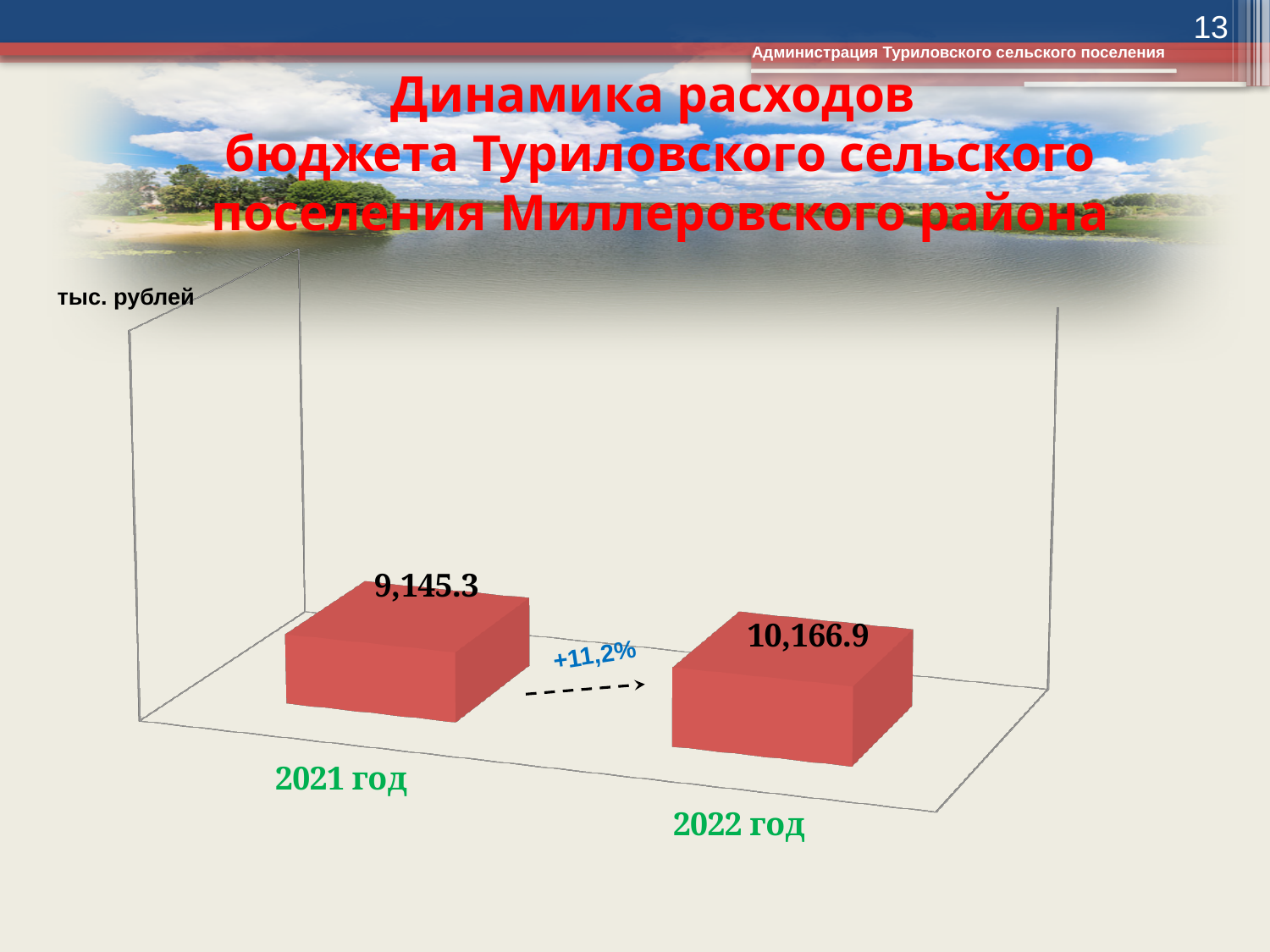
How many bars are shown in the chart? 2 What unit is indicated for the values in the chart? тыс. рублей What is the value for 2021 год? 9,145.3 What is the difference between the values for 2022 год and 2021 год? 1,021.6 Which year has the lower value? 2021 год Do the values rise or fall from 2021 год to 2022 год? rise What percentage change is shown on the arrow between the two bars? +11,2% Is the value for 2022 год larger or smaller than the value for 2021 год? larger What kind of chart is shown on the slide? bar chart Which year has the higher value? 2022 год What is the value for 2022 год? 10,166.9